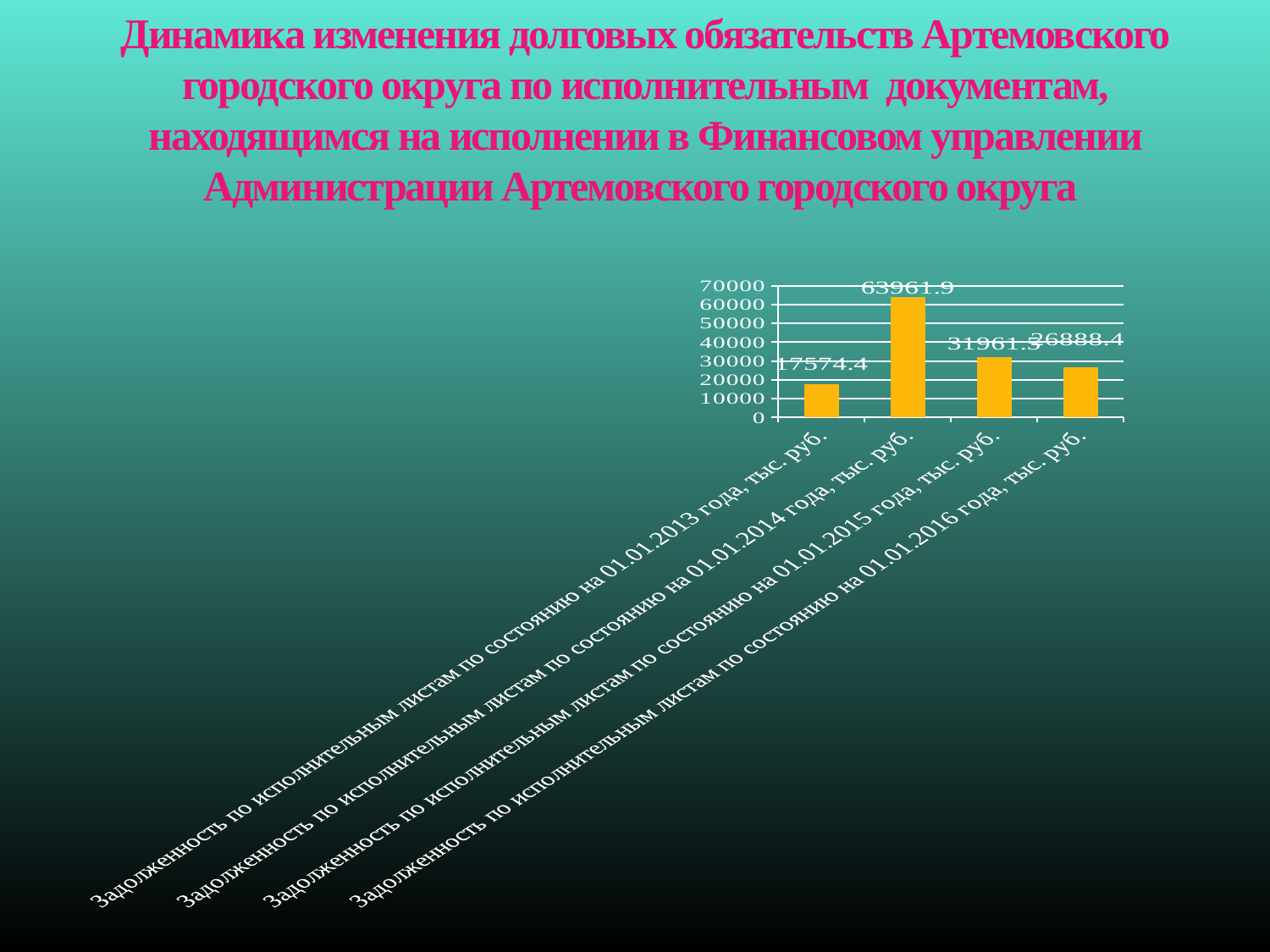
What kind of chart is shown on the slide? bar chart Do the values rise or fall from 01.01.2014 to 01.01.2016? fall What is the value of the debt on executive documents as of 01.01.2016 (thousand rubles)? 26888.4 As of which date is the debt on executive documents the lowest? 01.01.2013 As of which date is the debt on executive documents the highest? 01.01.2014 Which is larger: the debt as of 01.01.2015 or the debt as of 01.01.2016? 01.01.2015 What is the difference between the debt as of 01.01.2014 and the debt as of 01.01.2016? 37073.5 What is the value of the debt on executive documents as of 01.01.2014 (thousand rubles)? 63961.9 What is the value of the debt on executive documents as of 01.01.2013 (thousand rubles)? 17574.4 How many bars (dates) are shown in the chart? 4 Is the value for the debt as of 01.01.2015 greater or less than 40000? less What is the difference between the debt as of 01.01.2014 and the debt as of 01.01.2013? 46387.5